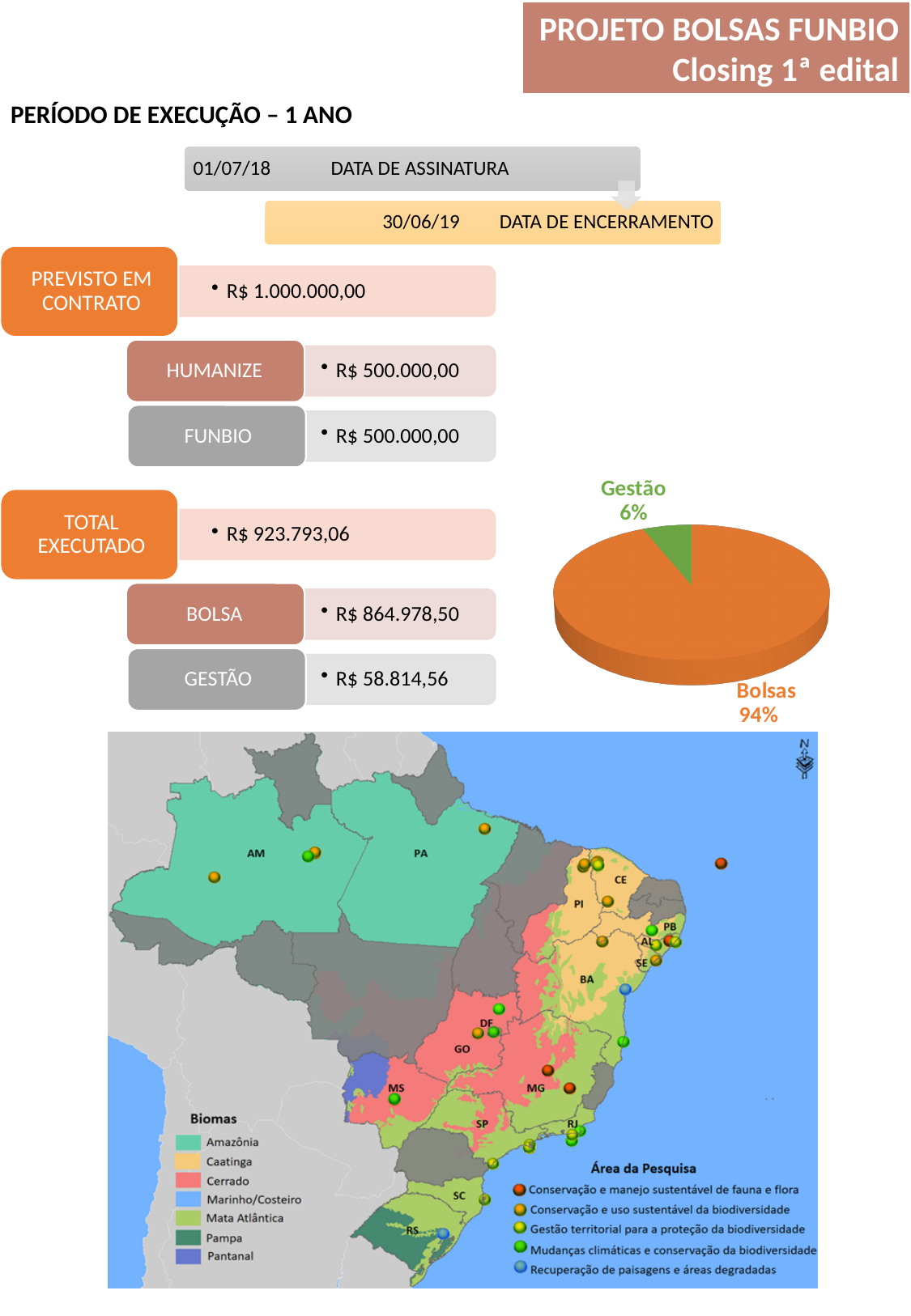
What colour is the Gestão slice in the pie chart? green What colour is the Bolsas slice in the pie chart? orange In the pie chart, what share does Gestão represent? 6% By how many percentage points does the Bolsas share exceed the Gestão share in the pie chart? 88 In the pie chart, which is larger, Bolsas or Gestão? Bolsas Which slice of the pie chart is the smallest? Gestão Which slice of the pie chart is the largest? Bolsas How many slices does the pie chart have? 2 In the pie chart, what share does Bolsas represent? 94% What type of chart is shown on the right side of the slide? pie chart